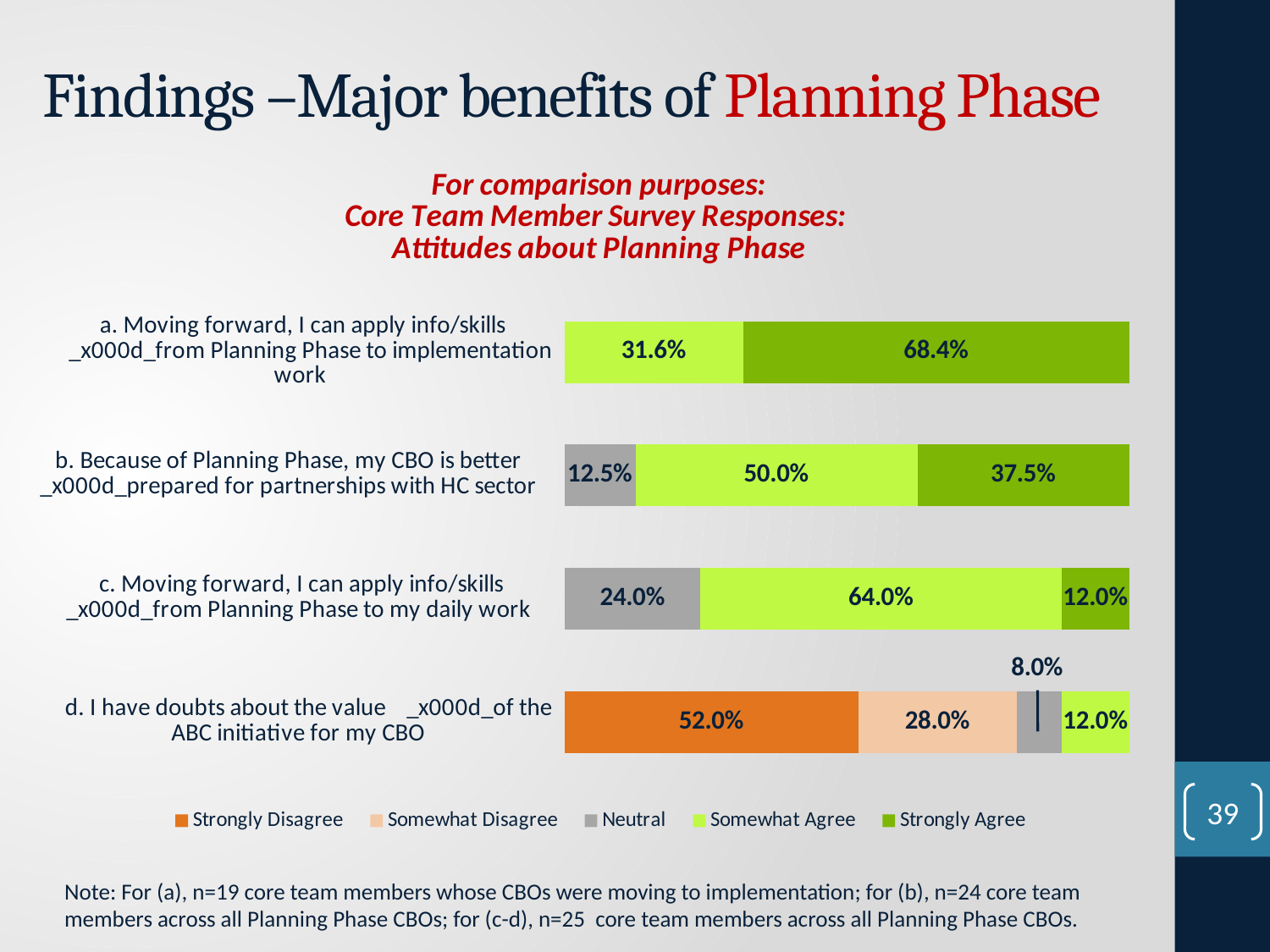
What is the Neutral percentage for statement (c), applying info/skills from Planning Phase to daily work? 24.0% How many survey statements are shown in the chart? 4 For statement (a), how many percentage points higher is Strongly Agree than Somewhat Agree? 36.8 percentage points Which statement has the larger Neutral share, (b) or (c)? c Which statement has the highest Strongly Agree percentage? a. Moving forward, I can apply info/skills from Planning Phase to implementation work What is the Somewhat Agree percentage for statement (b), that the CBO is better prepared for partnerships with the HC sector? 50.0% How many response categories does the legend list? 5 What is the Somewhat Disagree percentage for statement (d)? 28.0% What percentage strongly disagreed with statement (d), having doubts about the value of the ABC initiative? 52.0% What is the total of the segments in the bar for statement (d)? 100.0% What percentage of core team members strongly agreed with statement (a), that they can apply info/skills from Planning Phase to implementation work? 68.4% What type of chart is shown on the slide? Stacked bar chart